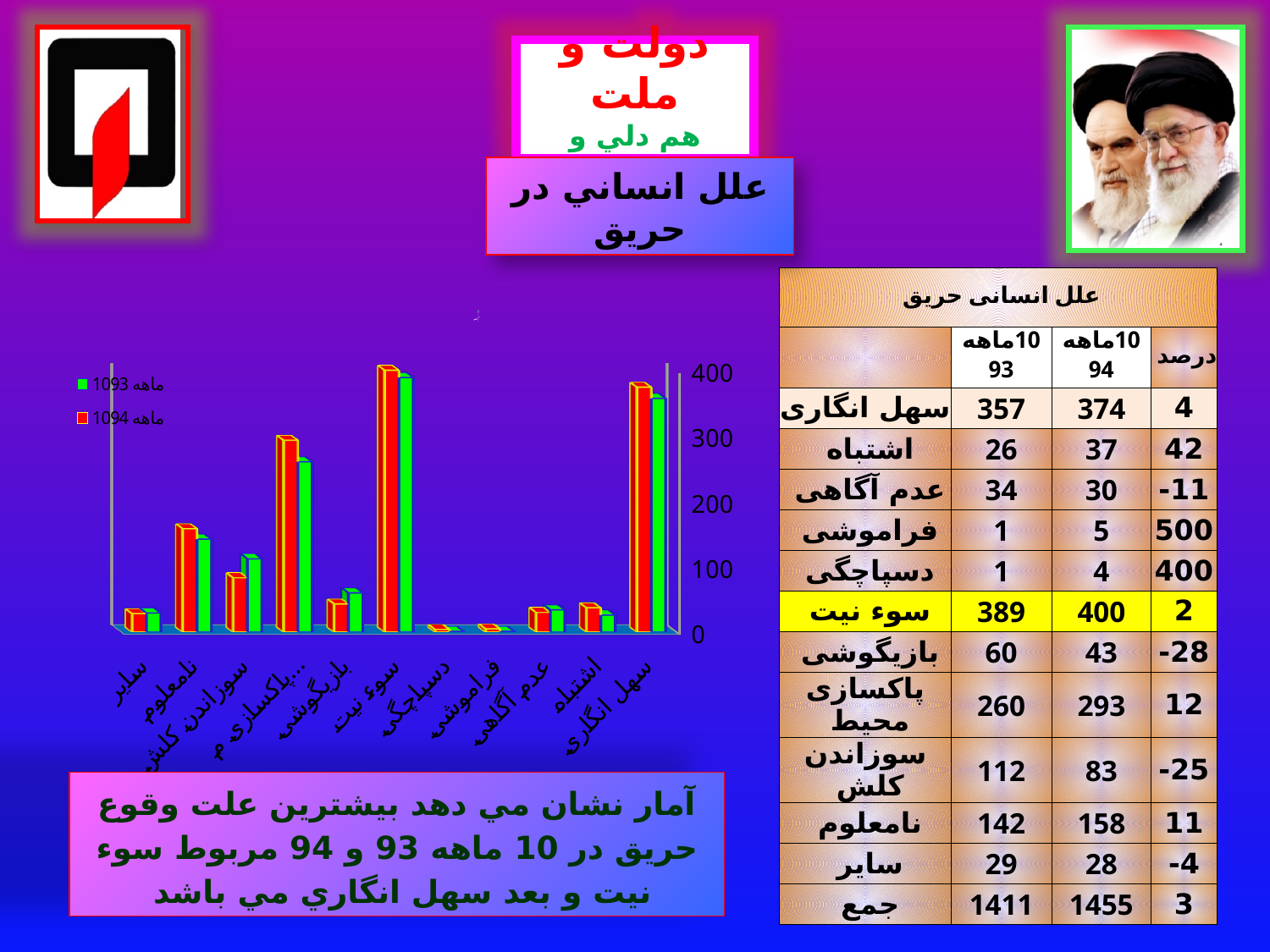
Which category has the larger bars, پاکسازی محیط or نامعلوم? پاکسازی محیط Is the value for نامعلوم in the red (10 ماهه 94) series greater or less than 100? greater Is the value for اشتباه in the green (10 ماهه 93) series greater or less than 100? less Is the value for پاکسازی محیط in the red (10 ماهه 94) series greater or less than 200? greater What kind of chart is shown on the slide? bar chart For سوزاندن کلش, which series has the larger bar, the green (10 ماهه 93) or the red (10 ماهه 94)? green (10 ماهه 93) How many categories are shown along the x axis of the chart? 11 Which category has the tallest bars in the chart? سوء نیت How many series does the chart legend list? 2 What colour are the bars for the 10 ماهه 94 series in the chart? red